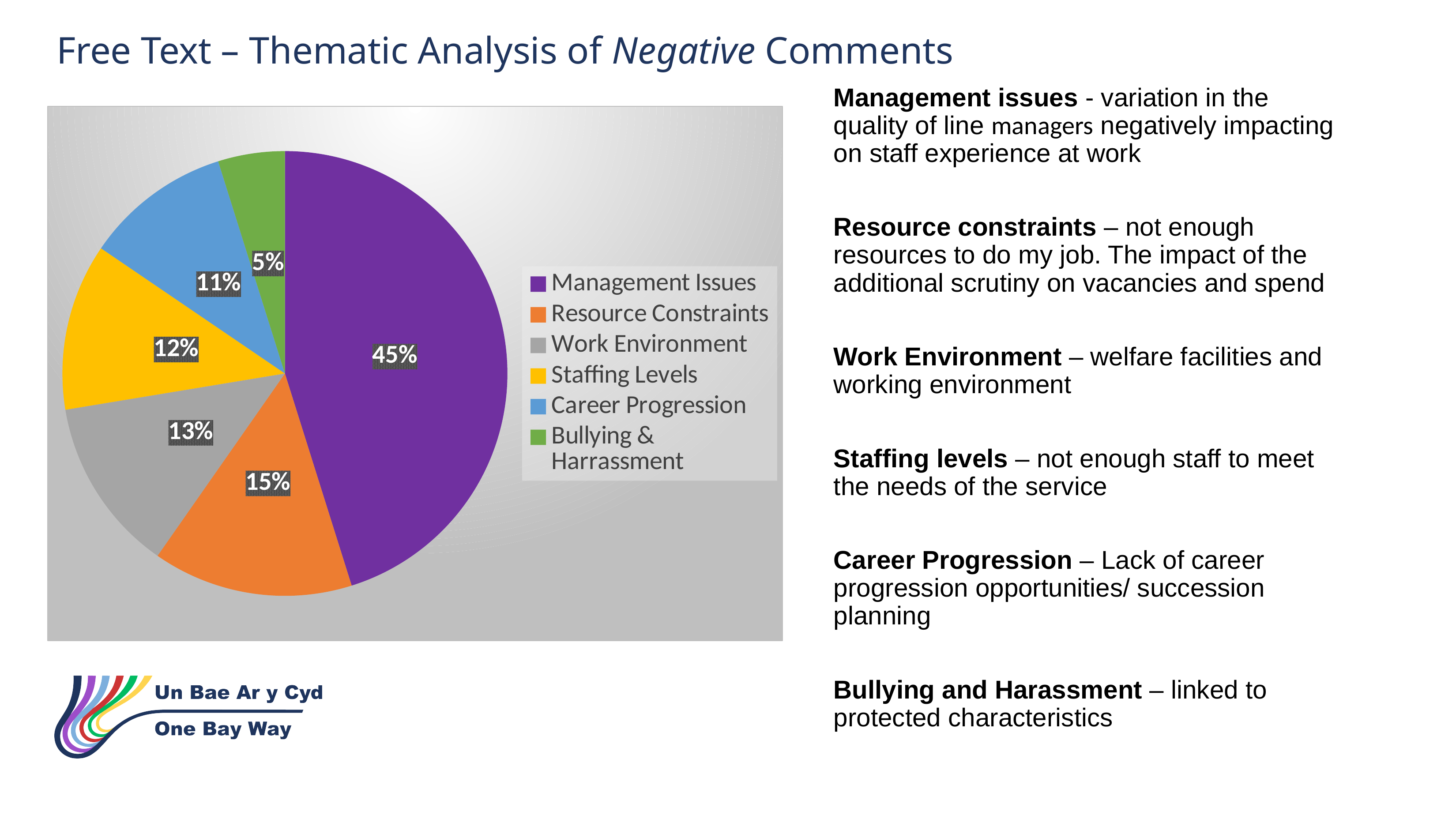
What kind of chart is shown on the slide? Pie chart What percentage of negative comments relate to Work Environment? 13% What percentage of negative comments relate to Staffing Levels? 12% What percentage of negative comments relate to Management Issues? 45% How many percentage points larger is the Management Issues share than the Resource Constraints share? 30 Which theme has the largest share of negative comments? Management Issues What colour is the Staffing Levels slice in the pie chart? Yellow How many themes (slices) does the pie chart show? 6 Which theme has the smallest share of negative comments? Bullying & Harrassment Which has a larger share: Work Environment or Career Progression? Work Environment What percentage of negative comments relate to Resource Constraints? 15% What percentage of negative comments relate to Career Progression? 11%